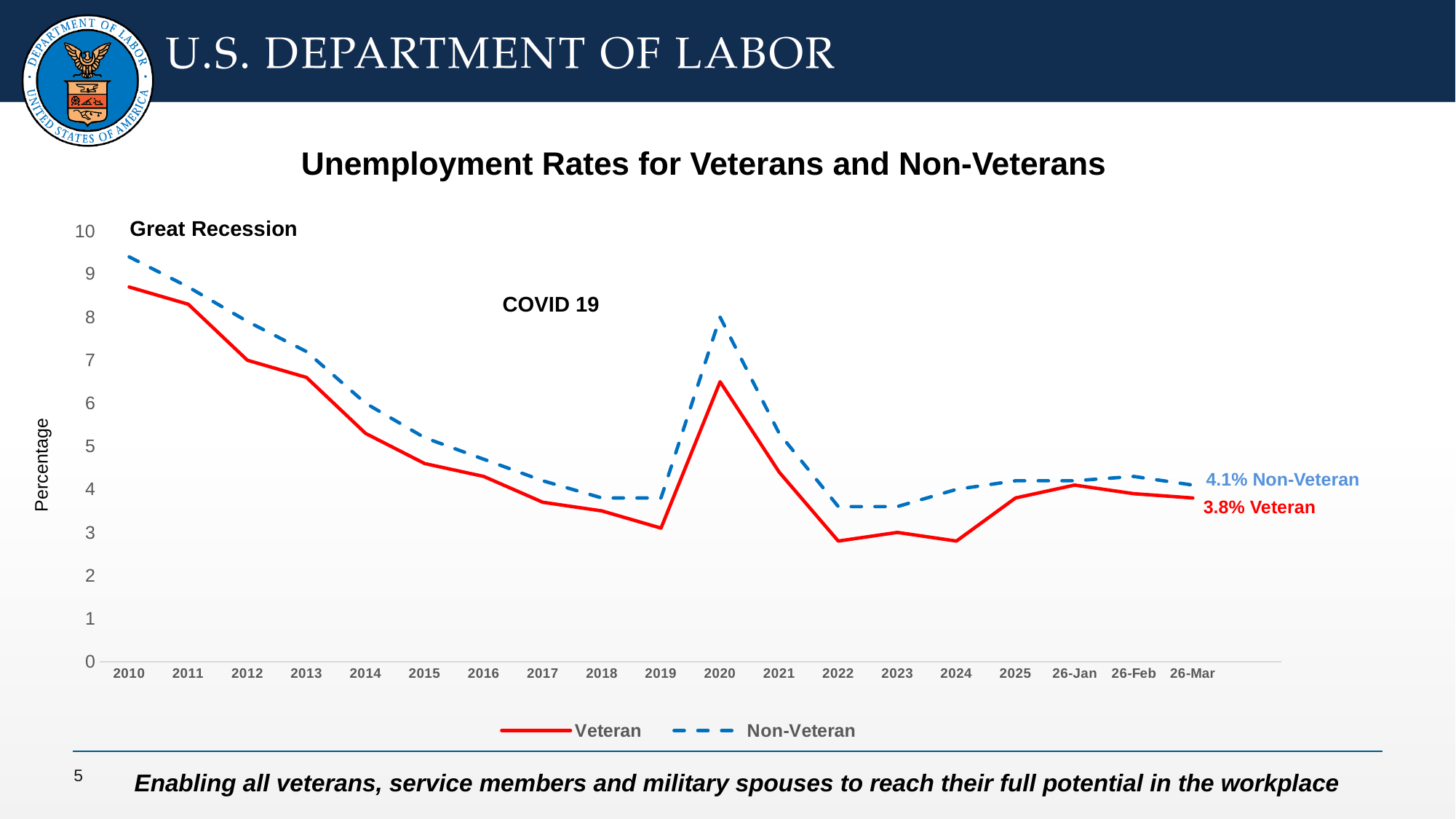
Is the Veteran value for 2010 greater or less than 8? greater At 26-Mar, which series has the higher unemployment rate, Veteran or Non-Veteran? Non-Veteran What kind of chart is shown on the slide? line chart What is the difference between the Non-Veteran and Veteran rates at 26-Mar? 0.3% What is the Veteran unemployment rate at 26-Mar? 3.8% In which year is the Non-Veteran unemployment rate highest? 2010 How many points are labelled along the x axis? 19 Is the Veteran value for 2022 greater or less than 3? less How many series does the legend list? 2 What is the label on the y axis? Percentage What is the Non-Veteran unemployment rate at 26-Mar? 4.1% Does the Veteran unemployment rate rise or fall from 2010 to 2019? fall